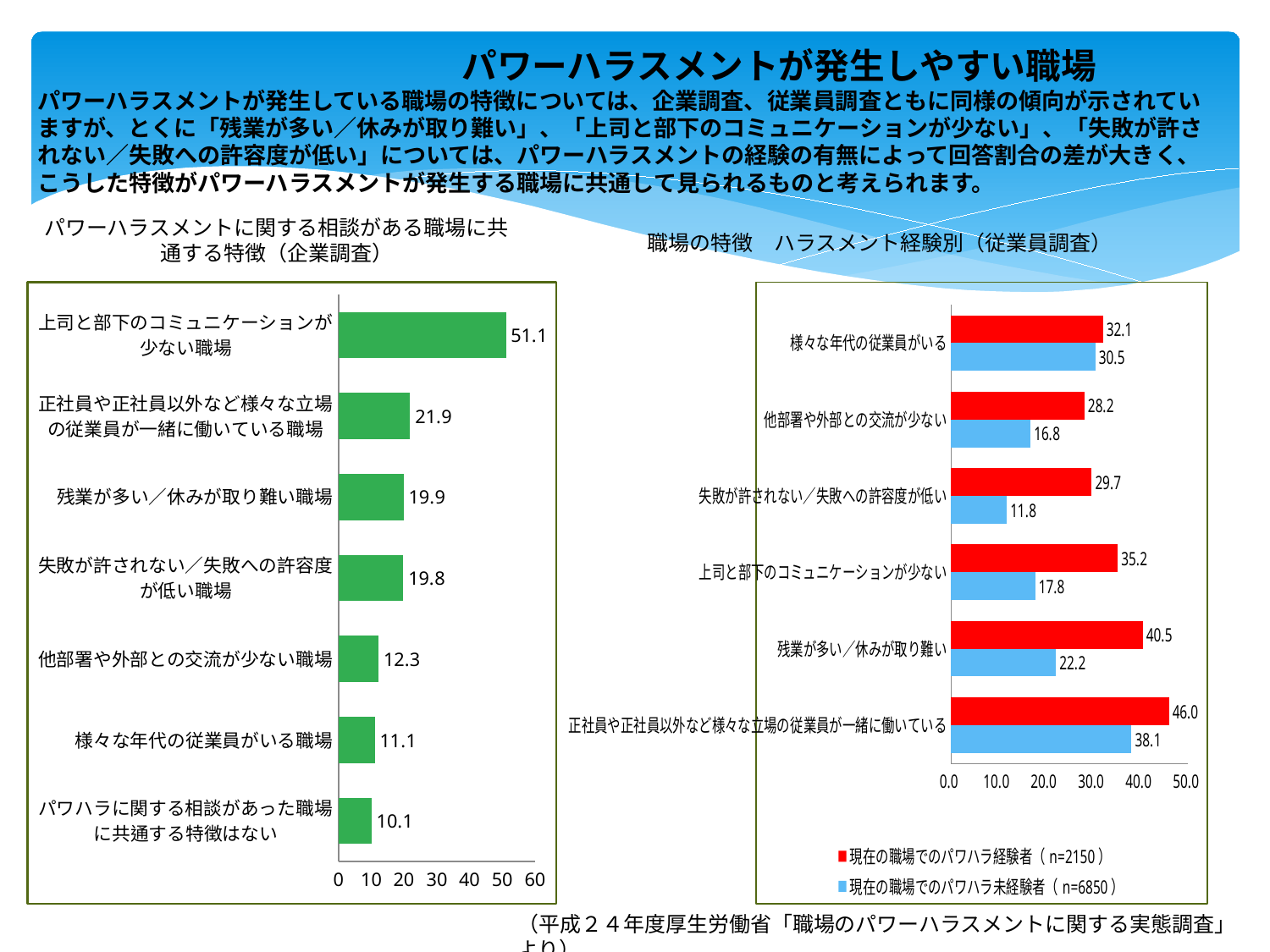
右のグラフ（従業員調査）で、「上司と部下のコミュニケーションが少ない」のパワハラ経験者と未経験者の値の差はいくつですか？ 17.4 左のグラフ（企業調査）で、最も値が高い項目はどれですか？ 上司と部下のコミュニケーションが少ない職場 右のグラフ（従業員調査）で、「残業が多い／休みが取り難い」のパワハラ未経験者の値はいくつですか？ 22.2 左のグラフ（企業調査）で、最も値が低い項目はどれですか？ パワハラに関する相談があった職場に共通する特徴はない 右のグラフ（従業員調査）で、パワハラ経験者の値が最も高い項目はどれですか？ 正社員や正社員以外など様々な立場の従業員が一緒に働いている 右のグラフ（従業員調査）で、「様々な年代の従業員がいる」はパワハラ経験者と未経験者のどちらの値が大きいですか？ パワハラ経験者 左のグラフ（企業調査）には項目がいくつありますか？ 7 左のグラフ（企業調査）はどの種類のグラフですか？ 棒グラフ 右のグラフ（従業員調査）の凡例には系列がいくつありますか？ 2 左のグラフ「パワーハラスメントに関する相談がある職場に共通する特徴（企業調査）」で、「上司と部下のコミュニケーションが少ない職場」の値はいくつですか？ 51.1 右のグラフ「職場の特徴 ハラスメント経験別（従業員調査）」で、「失敗が許されない／失敗への許容度が低い」のパワハラ経験者の値はいくつですか？ 29.7 左のグラフ（企業調査）で、「残業が多い／休みが取り難い職場」と「他部署や外部との交流が少ない職場」の値の差はいくつですか？ 7.6